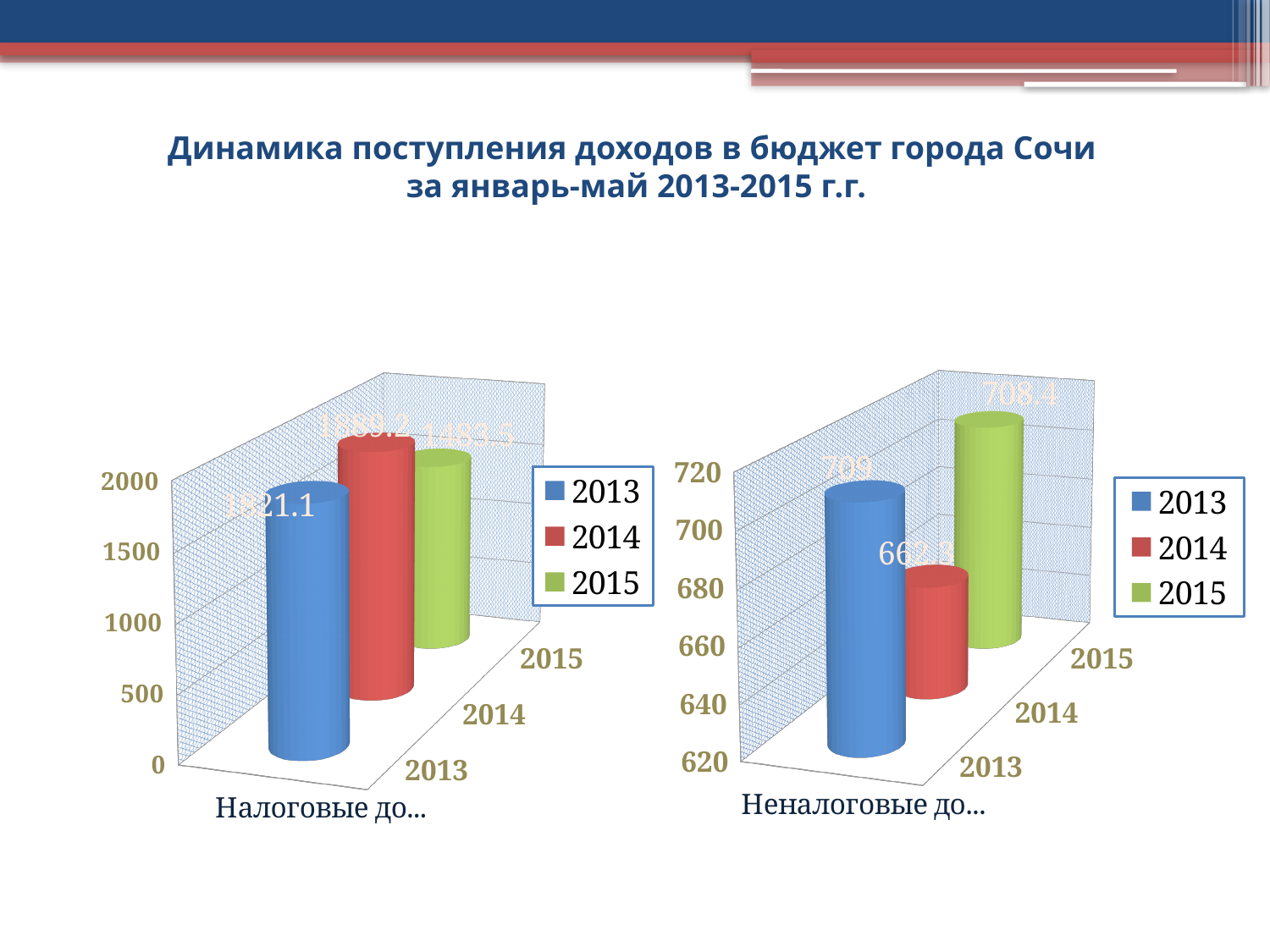
On the left chart (Налоговые доходы), which year has the highest value? 2014 On the right chart (Неналоговые доходы), which year has the lowest value? 2014 On the left chart (Налоговые доходы), what is the difference between the 2013 value and the 2015 value? 337.6 On the left chart (Налоговые доходы), what is the value for 2013? 1821.1 How many series does the legend of the left chart list? 3 What kind of chart is the right chart (Неналоговые доходы)? bar chart On the right chart (Неналоговые доходы), is the value for 2014 greater or less than 680? less On the left chart (Налоговые доходы), is the value for 2015 greater or less than 1000? greater On the right chart (Неналоговые доходы), what is the value for 2015? 708.4 On the left chart (Налоговые доходы), what is the value for 2015? 1483.5 On the right chart (Неналоговые доходы), what is the value for 2013? 709 On the left chart (Налоговые доходы), which year has the lowest value? 2015